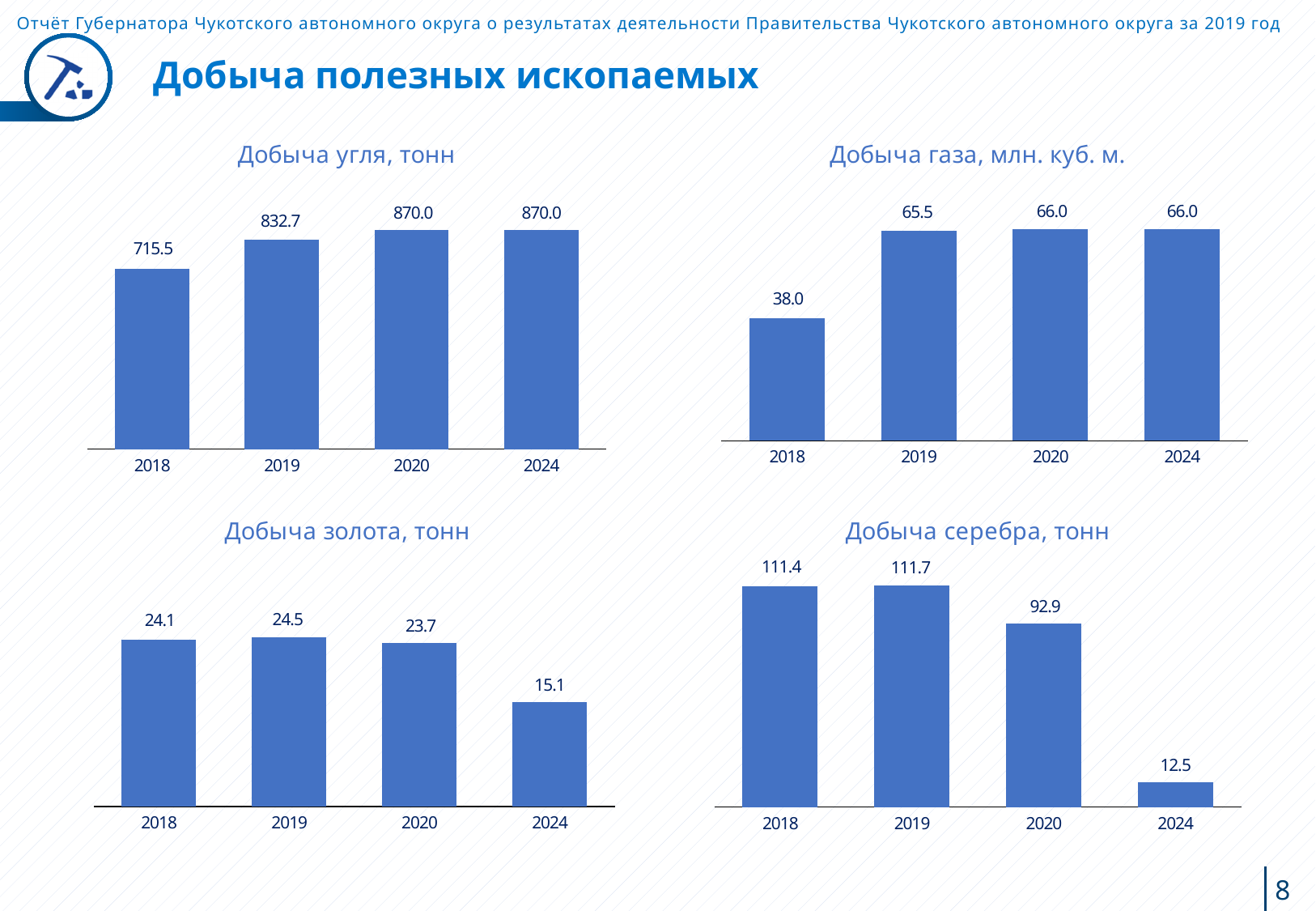
In the chart 'Добыча золота, тонн', what is the value for 2024? 15.1 In the chart 'Добыча серебра, тонн', do the values rise or fall from 2019 to 2024? fall In the chart 'Добыча газа, млн. куб. м.', what is the value for 2019? 65.5 In the chart 'Добыча угля, тонн', what is the value for 2018? 715.5 In the chart 'Добыча серебра, тонн', what is the difference between the values for 2020 and 2024? 80.4 In the chart 'Добыча газа, млн. куб. м.', which year has the lowest value? 2018 In the chart 'Добыча золота, тонн', which is larger, the value for 2019 or the value for 2020? 2019 How many charts are shown on the slide? 4 In the chart 'Добыча серебра, тонн', which year has the highest value? 2019 In the chart 'Добыча угля, тонн', what is the difference between the values for 2019 and 2018? 117.2 What kind of chart is 'Добыча золота, тонн'? bar chart How many bars are in the chart 'Добыча серебра, тонн'? 4